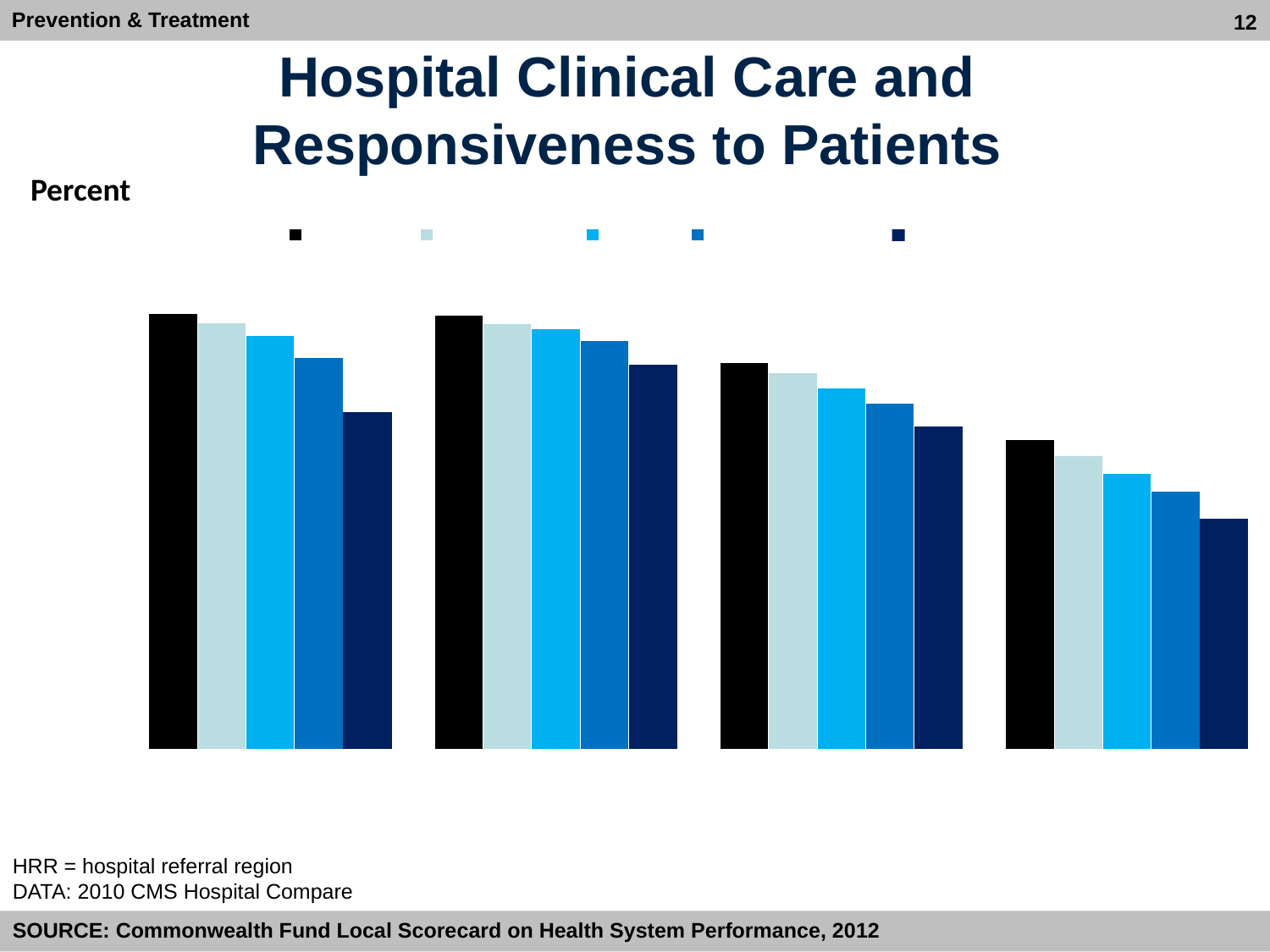
Is the black bar in the first group taller or shorter than the black bar in the fourth group? taller Counting from the left, which group of bars has the shortest bars overall? the fourth group What label is shown for the vertical axis of the chart? Percent How many series does the legend list? 5 What kind of chart is shown on the slide? bar chart How many bars are in each group? 5 How many groups of bars are plotted in the chart? 4 Within each group, do the bars rise or fall from left to right? fall What is the title of the chart? Hospital Clinical Care and Responsiveness to Patients